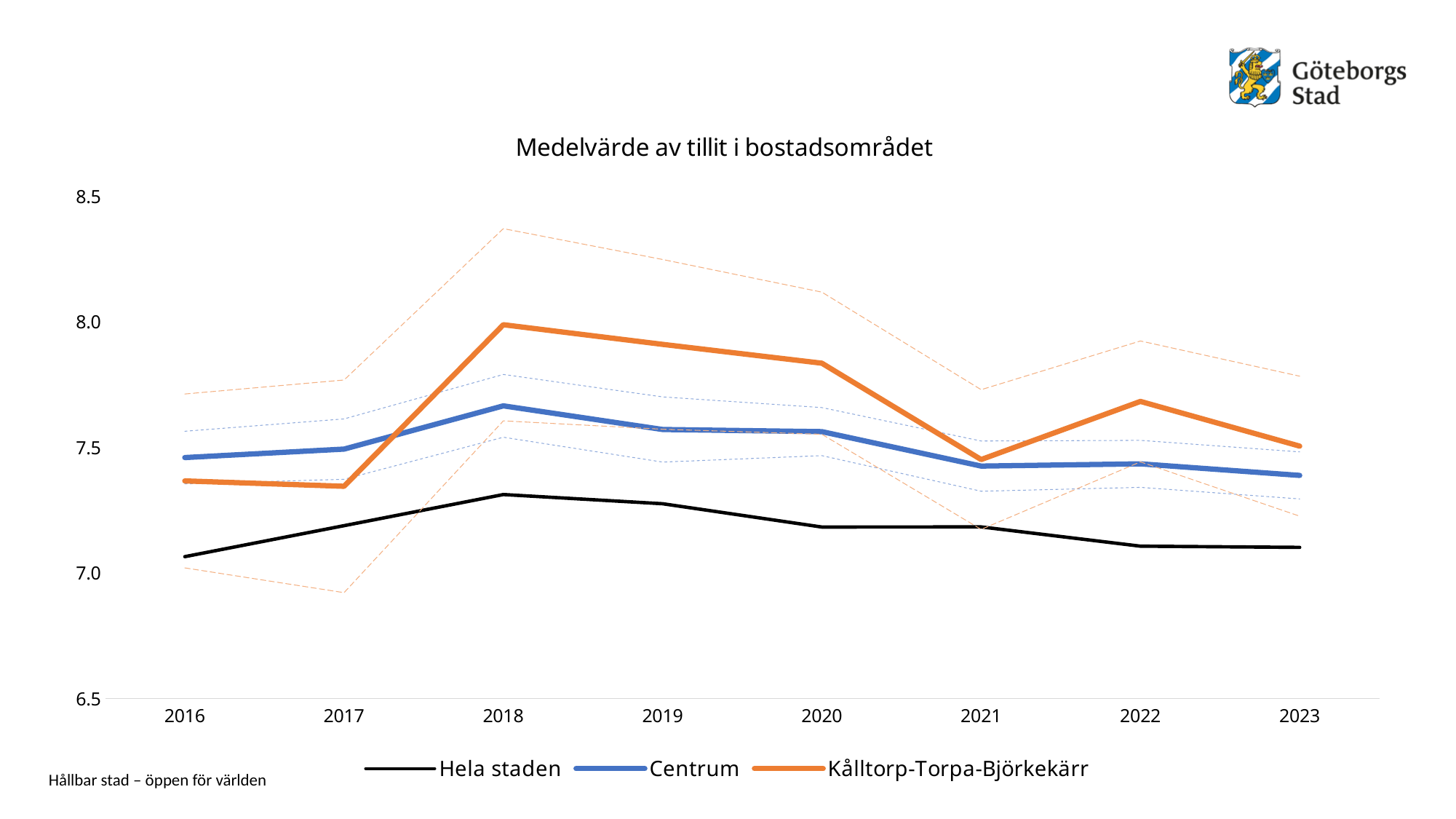
Is the value for Kålltorp-Torpa-Björkekärr in 2018 greater or less than 7.5? greater What kind of chart is shown on the slide? line chart Is the value for Hela staden in 2016 greater or less than 7.5? less In which year does the Kålltorp-Torpa-Björkekärr line reach its highest value? 2018 How many years are shown on the x axis? 8 How many series does the legend list? 3 In 2022, which is higher: Centrum or Kålltorp-Torpa-Björkekärr? Kålltorp-Torpa-Björkekärr Does the Hela staden line rise or fall from 2018 to 2023? fall In 2016, which is higher: Centrum or Kålltorp-Torpa-Björkekärr? Centrum In which year does the Hela staden line reach its highest value? 2018 Is the value for Kålltorp-Torpa-Björkekärr in 2017 greater or less than 7.5? less What is the title of the chart? Medelvärde av tillit i bostadsområdet